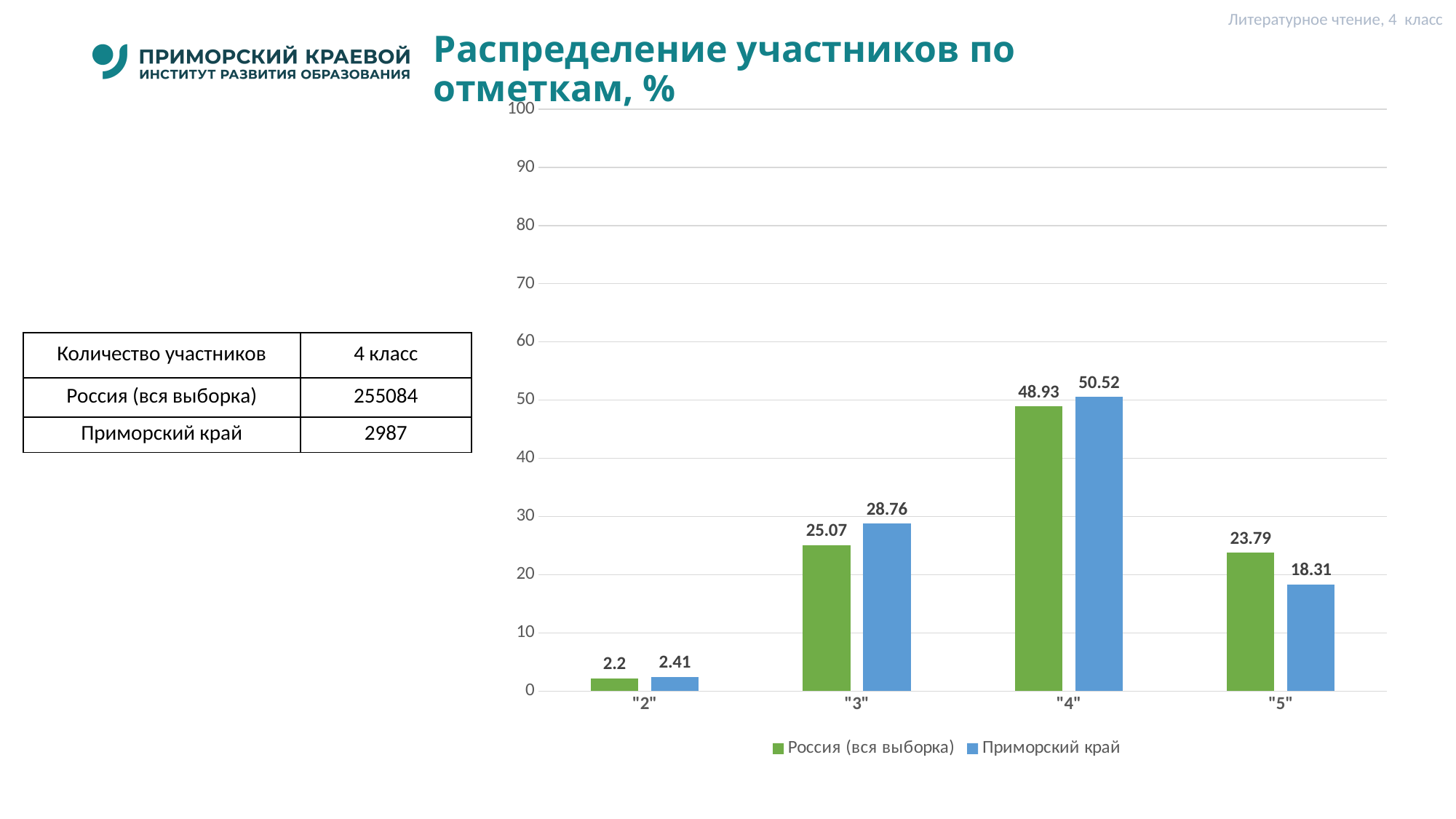
What colour are the bars for Приморский край? blue How many series does the legend list? 2 Which mark has the highest value for Россия (вся выборка)? "4" What is the value for Приморский край at mark "2"? 2.41 What is the value for Приморский край at mark "4"? 50.52 What kind of chart is shown on the slide? bar chart Which mark has the lowest value for Приморский край? "2" At mark "5", which series has the larger value: Россия (вся выборка) or Приморский край? Россия (вся выборка) Is the value for Приморский край at mark "4" greater or less than 50? greater What is the difference between Приморский край and Россия (вся выборка) at mark "3"? 3.69 How many mark categories are shown on the x axis? 4 What is the value for Россия (вся выборка) at mark "3"? 25.07